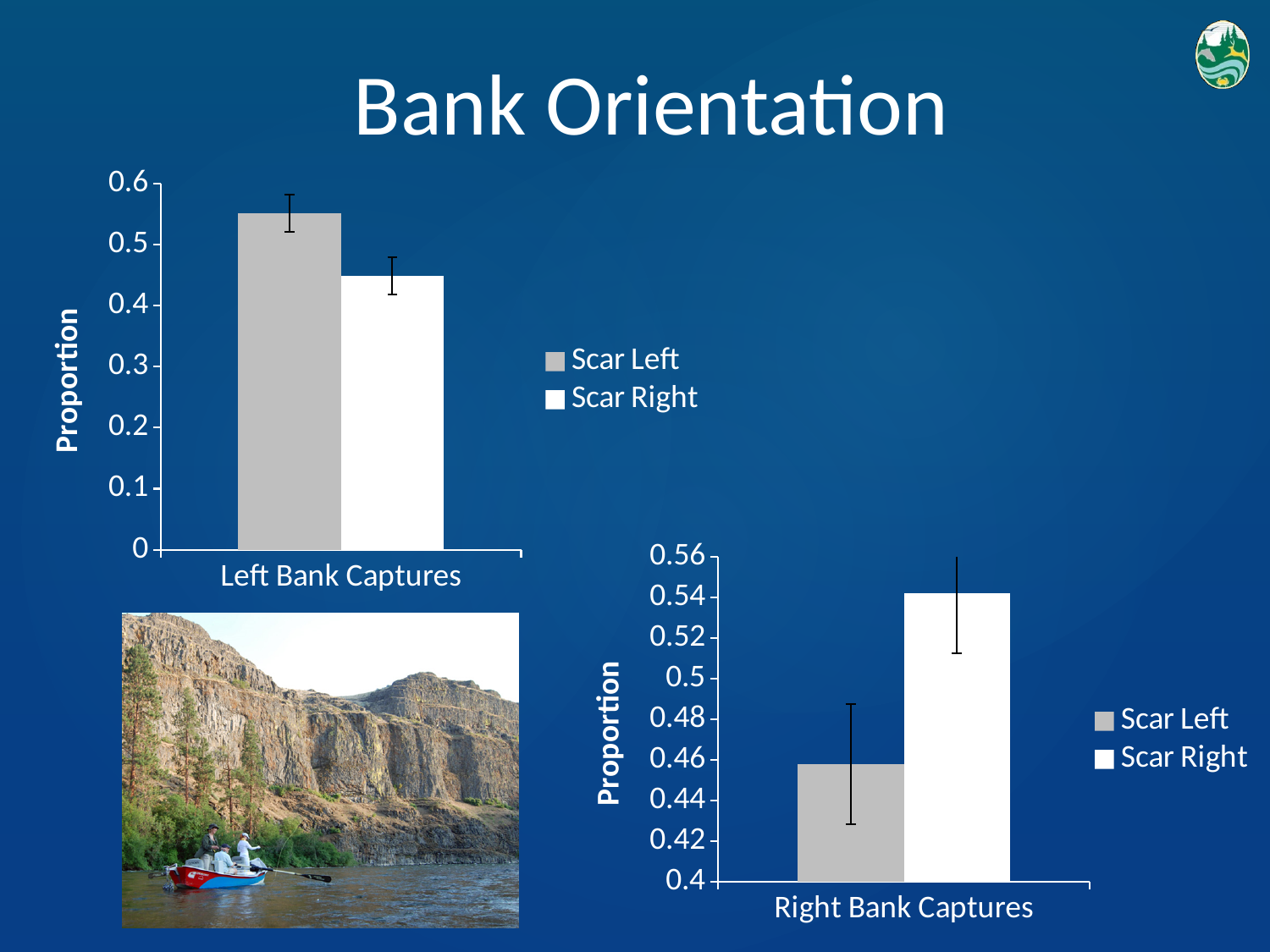
In the Right Bank Captures chart, what colour is the Scar Right bar? white In the Right Bank Captures chart, which series has the lowest bar? Scar Left In the Left Bank Captures chart, what kind of chart is shown? bar chart In the Left Bank Captures chart, what is the y-axis title? Proportion In the Right Bank Captures chart, is the value for Scar Right greater or less than 0.5? greater In the Right Bank Captures chart, which series has the higher bar, Scar Left or Scar Right? Scar Right In the Left Bank Captures chart, which series has the higher bar, Scar Left or Scar Right? Scar Left In the Right Bank Captures chart, how many bars are plotted? 2 In the Left Bank Captures chart, how many series does the legend list? 2 In the Left Bank Captures chart, is the value for Scar Right greater or less than 0.5? less In the Right Bank Captures chart, is the value for Scar Left greater or less than 0.5? less